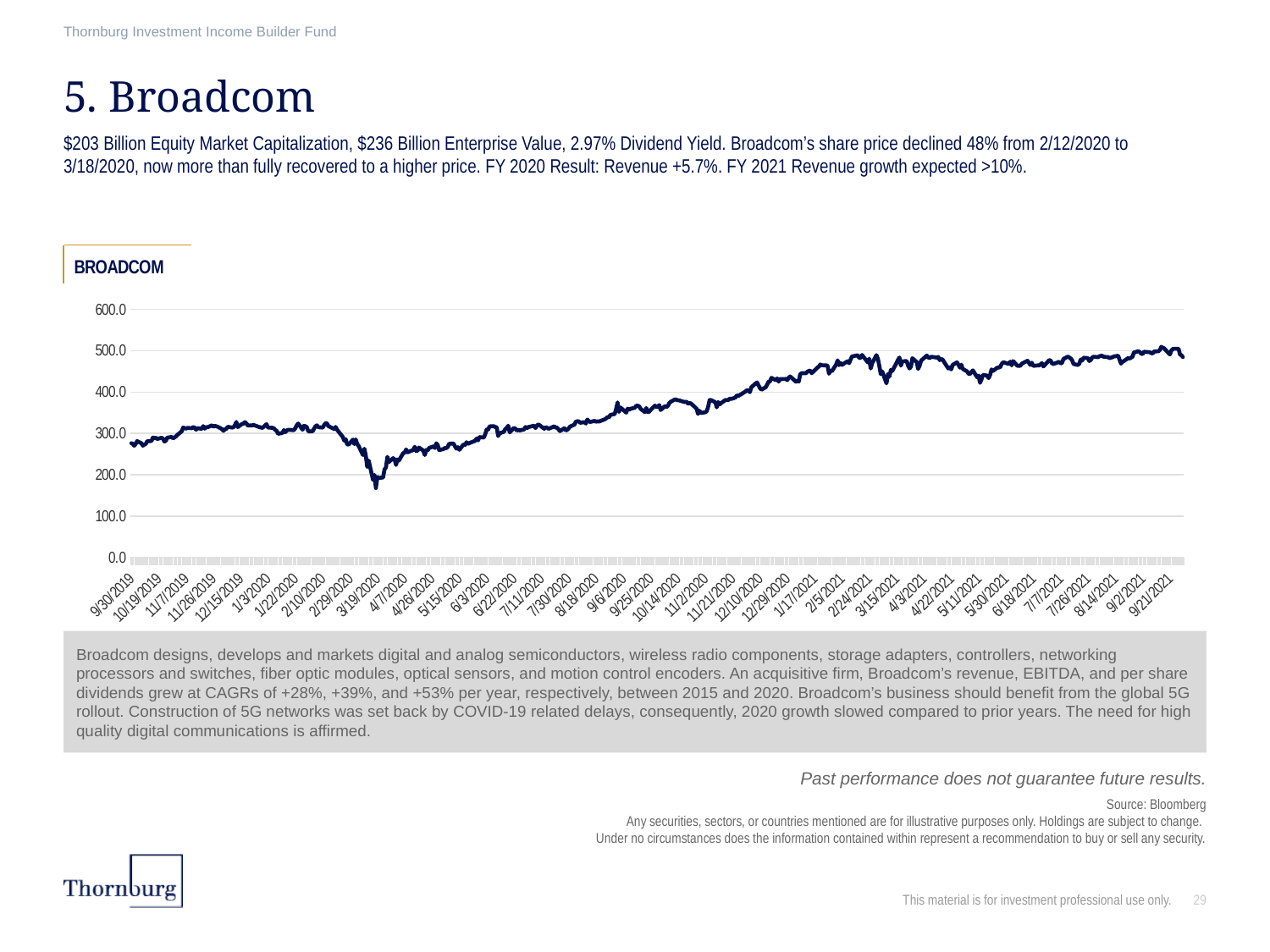
How many data series are plotted in the chart? 1 What kind of chart is shown on the slide? Line chart Is the value for 2/5/2021 greater or less than 400? greater What is the title of the chart? BROADCOM Is the value for 10/14/2020 greater or less than 400? less Which is larger, the value for 9/21/2021 or the value for 9/30/2019? 9/21/2021 What is the highest value shown on the y axis of the chart? 600.0 Overall, does the line rise or fall from the left of the x axis to the right? Rise Is the value for 9/21/2021 greater or less than 400? greater Which is larger, the value for 1/3/2020 or the value for 3/19/2020? 1/3/2020